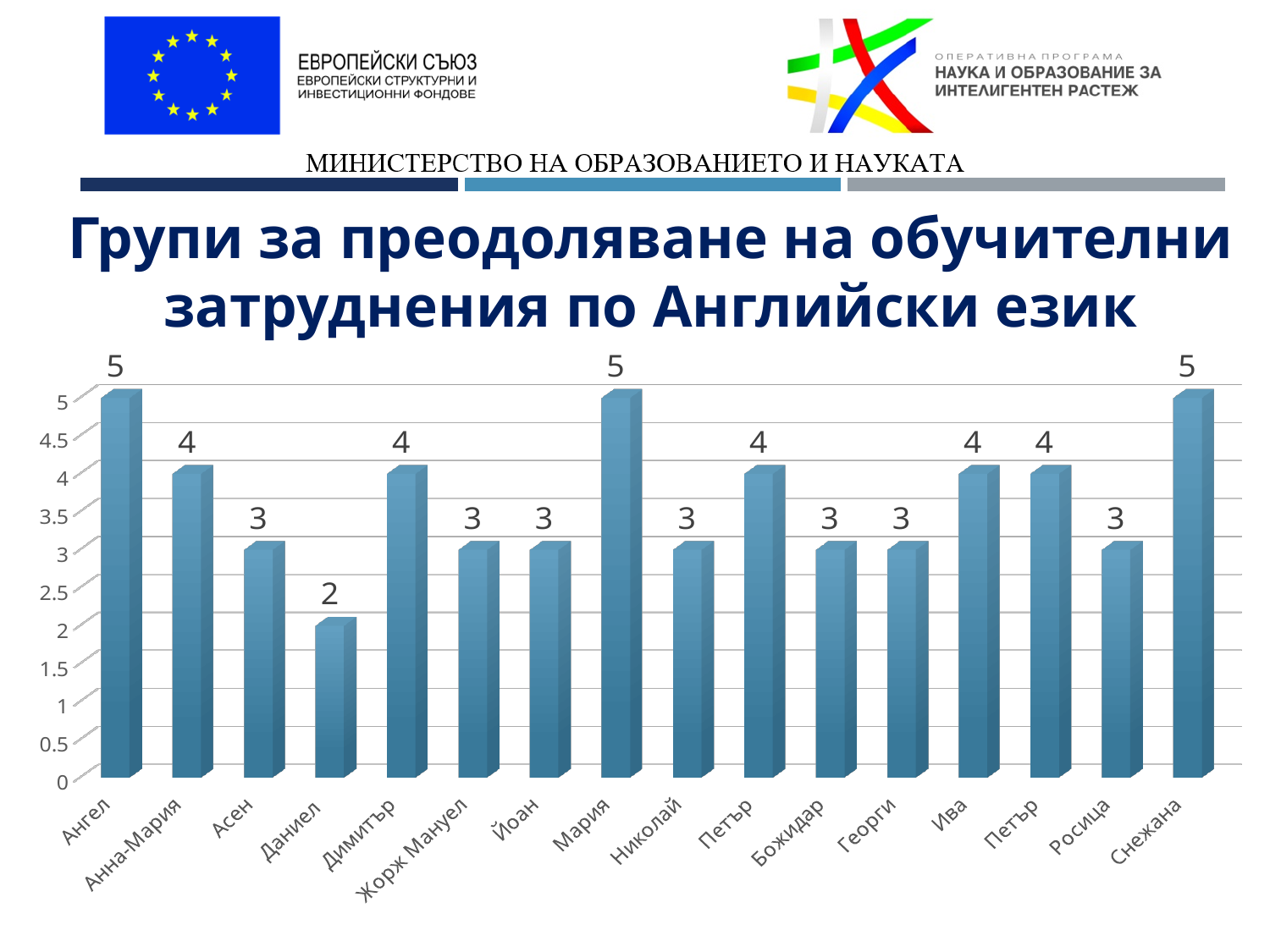
What is the value for Анна-Мария? 4 What is the difference between the values for Ива and Росица? 1 What is the difference between the values for Мария and Даниел? 3 What is the title of the slide above the chart? Групи за преодоляване на обучителни затруднения по Английски език What is the value for Жорж Мануел? 3 How many categories are shown on the x axis? 16 Which category has the lowest value? Даниел Which is larger, the value for Ангел or the value for Асен? Ангел What kind of chart is shown on the slide? Bar chart What is the highest value shown in the chart? 5 What is the value for Даниел? 2 What is the value for Снежана? 5